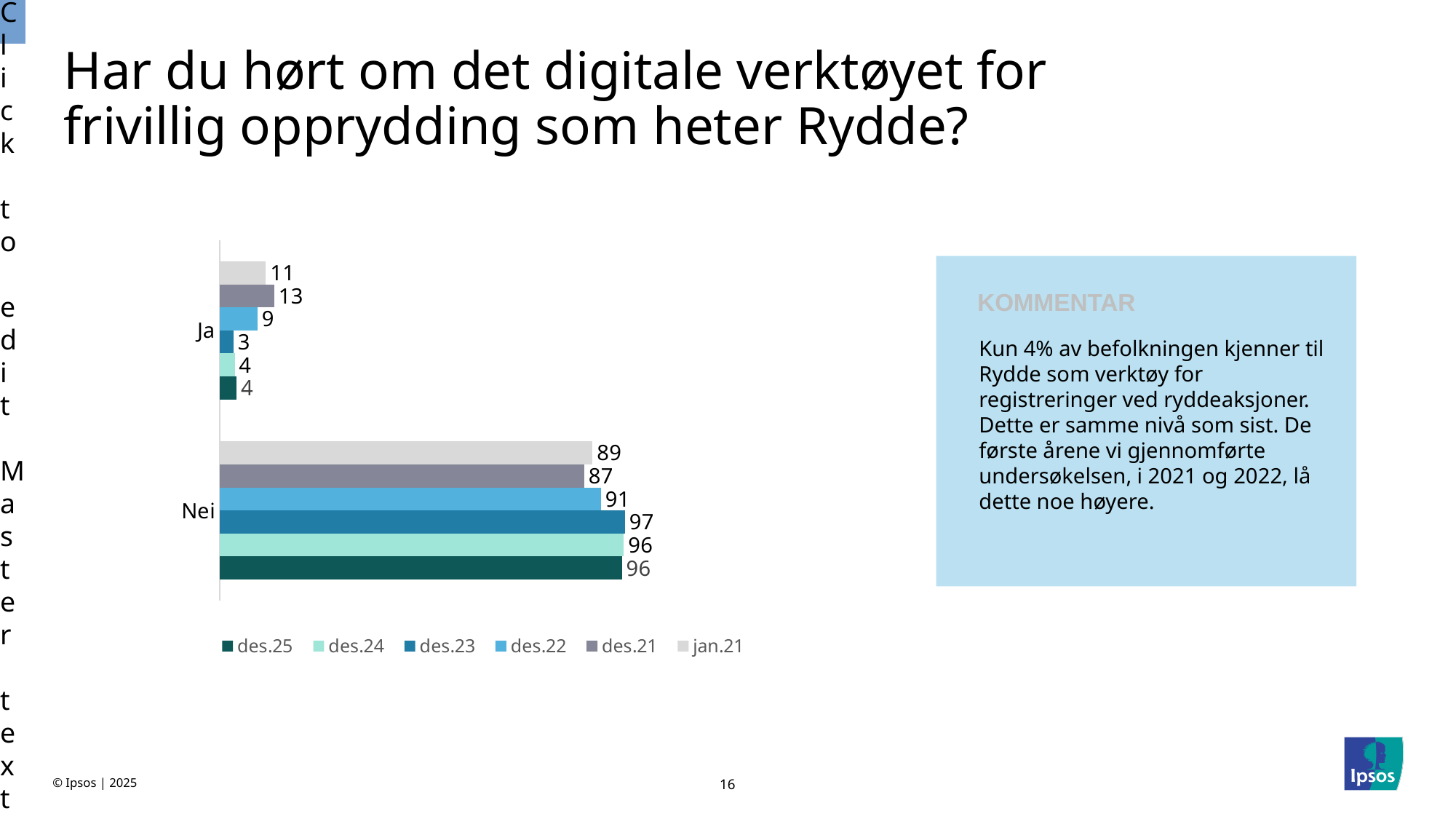
Which series has the lowest value for 'Nei'? des.21 Which series has the highest value for 'Ja'? des.21 What kind of chart is shown on the slide? bar chart How many categories are shown on the chart? 2 What is the difference between the 'Nei' values for des.23 and des.22? 6 How many series does the legend list? 6 Which series is shown in the lightest grey colour in the legend? jan.21 What is the value for 'Nei' in the jan.21 series? 89 What is the value for 'Ja' in the des.25 series? 4 What is the value for 'Nei' in the des.23 series? 97 Which is larger: the 'Ja' value for des.22 or for des.23? des.22 What is the value for 'Ja' in the des.21 series? 13